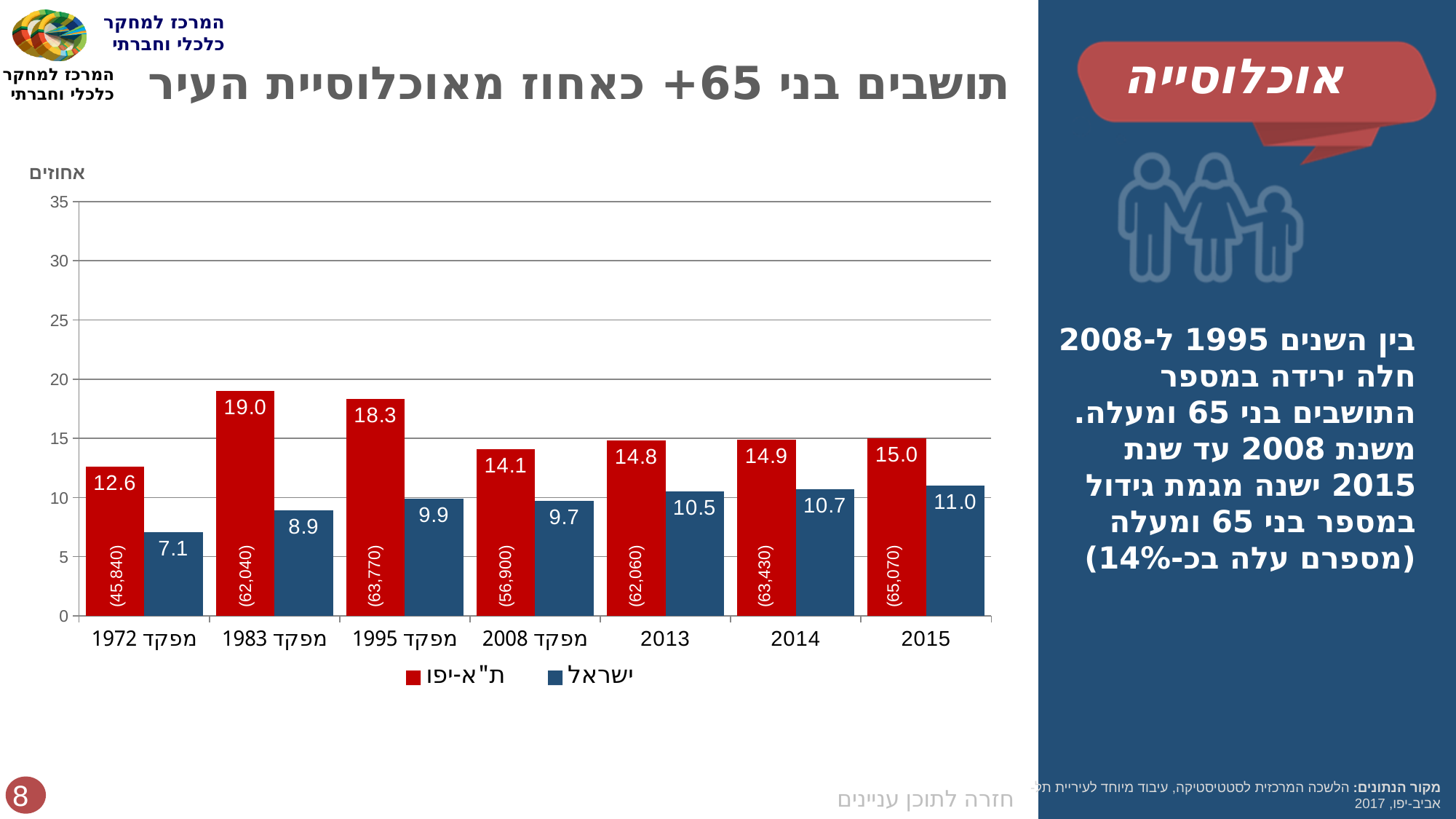
In which category is the ישראל value lowest? מפקד 1972 What kind of chart is shown on the slide? bar chart What is the value for ישראל in 2015? 11.0 How many series does the legend list? 2 In which category is the ת"א-יפו value highest? מפקד 1983 What is the difference between the ת"א-יפו and ישראל values in מפקד 2008? 4.4 Is the ת"א-יפו value in מפקד 1972 greater or less than 10? greater What is the value for ת"א-יפו in מפקד 1983? 19.0 What is the value for ישראל in מפקד 1972? 7.1 What number is printed in parentheses inside the ת"א-יפו bar for 2015? (65,070) Which is larger: the ת"א-יפו value in מפקד 1995 or in 2013? מפקד 1995 How many categories are shown on the x axis? 7